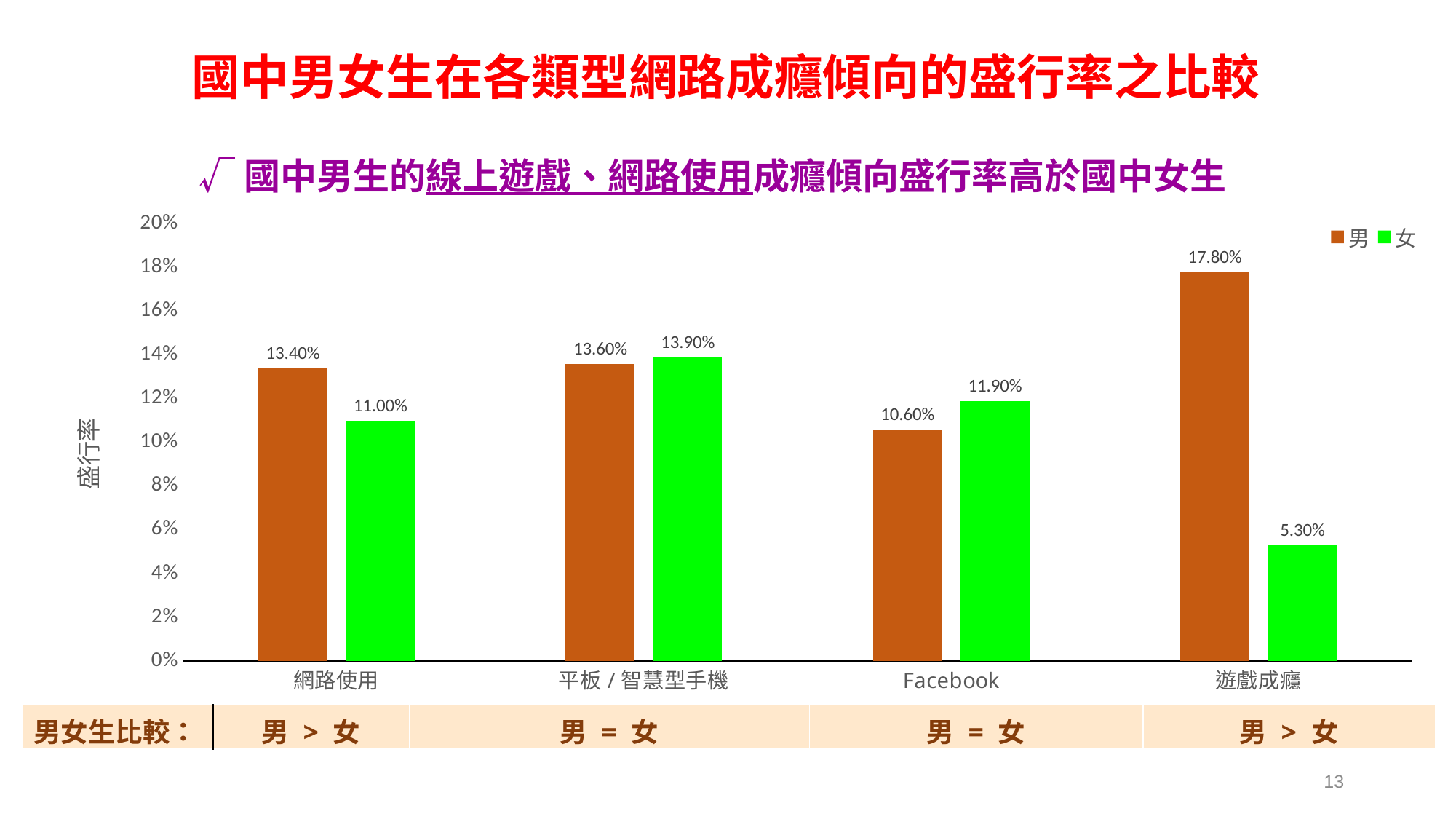
Which category has the highest value for 男? 遊戲成癮 What kind of chart is shown on the slide? bar chart Which category has the lowest value for 女? 遊戲成癮 How many series does the legend list? 2 What is the difference between 男 and 女 in the 遊戲成癮 category? 12.50% What is the label of the y axis? 盛行率 What is the value for 女 in the Facebook category? 11.90% What is the value for 女 in the 遊戲成癮 category? 5.30% How many categories are shown on the x axis? 4 What is the value for 男 in the 平板 / 智慧型手機 category? 13.60% What is the value for 男 in the 網路使用 category? 13.40% Which is larger in the Facebook category, 男 or 女? 女